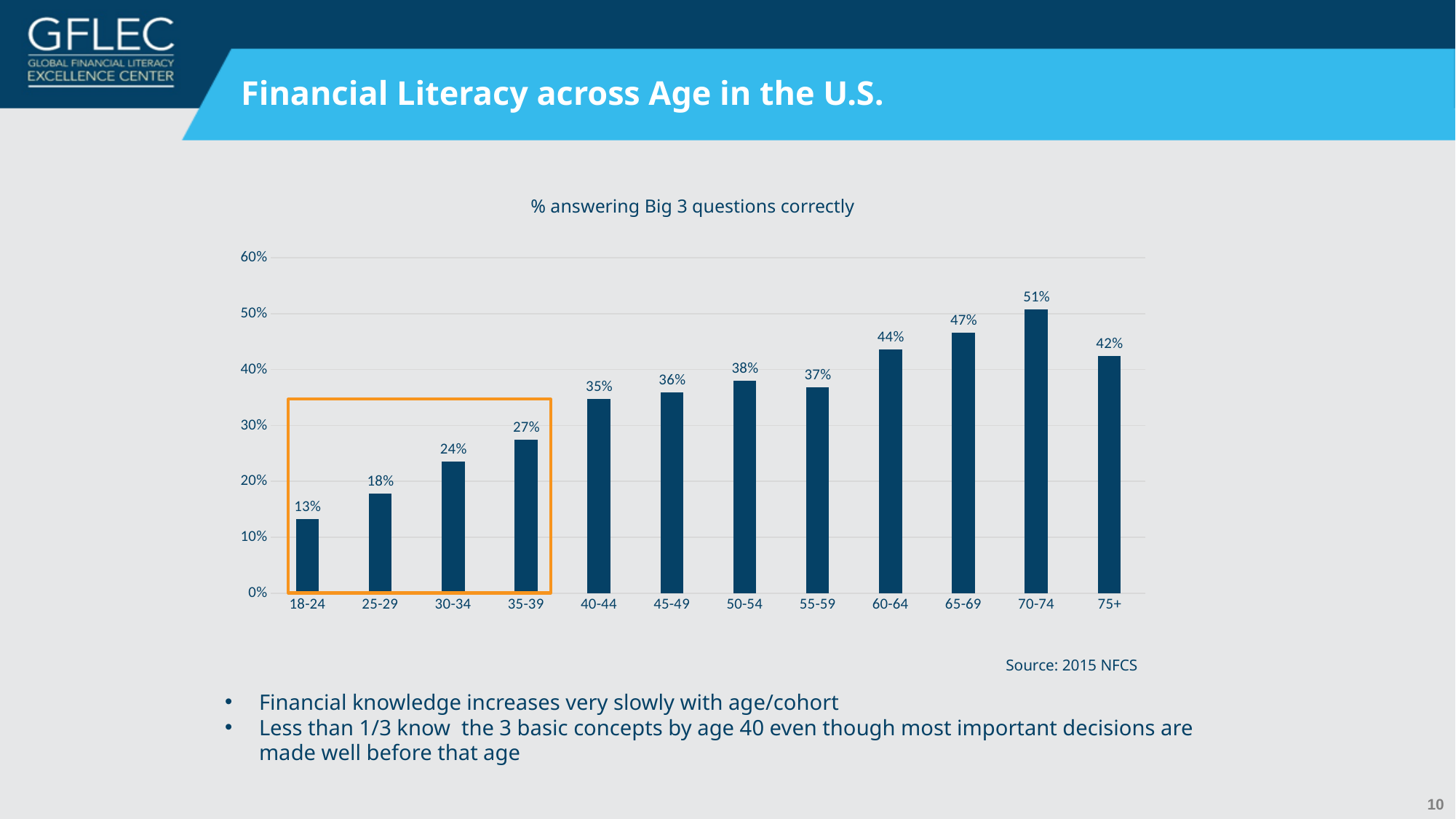
Do the values generally rise or fall from the 18-24 age group to the 70-74 age group? Rise What is the value shown for the 50-54 age group? 38% Which age group has the highest percentage answering the Big 3 questions correctly? 70-74 What percentage of the 18-24 age group answered the Big 3 questions correctly? 13% Which age group has a higher value, 55-59 or 60-64? 60-64 What is the difference between the values for the 35-39 and 30-34 age groups? 3% What is the difference between the values for the 70-74 and 18-24 age groups? 38% What kind of chart is shown on the slide? Bar chart Is the value for the 65-69 age group greater or less than 40%? greater How many age groups are shown on the chart? 12 What is the value shown for the 75+ age group? 42% Which age group has the lowest percentage answering the Big 3 questions correctly? 18-24